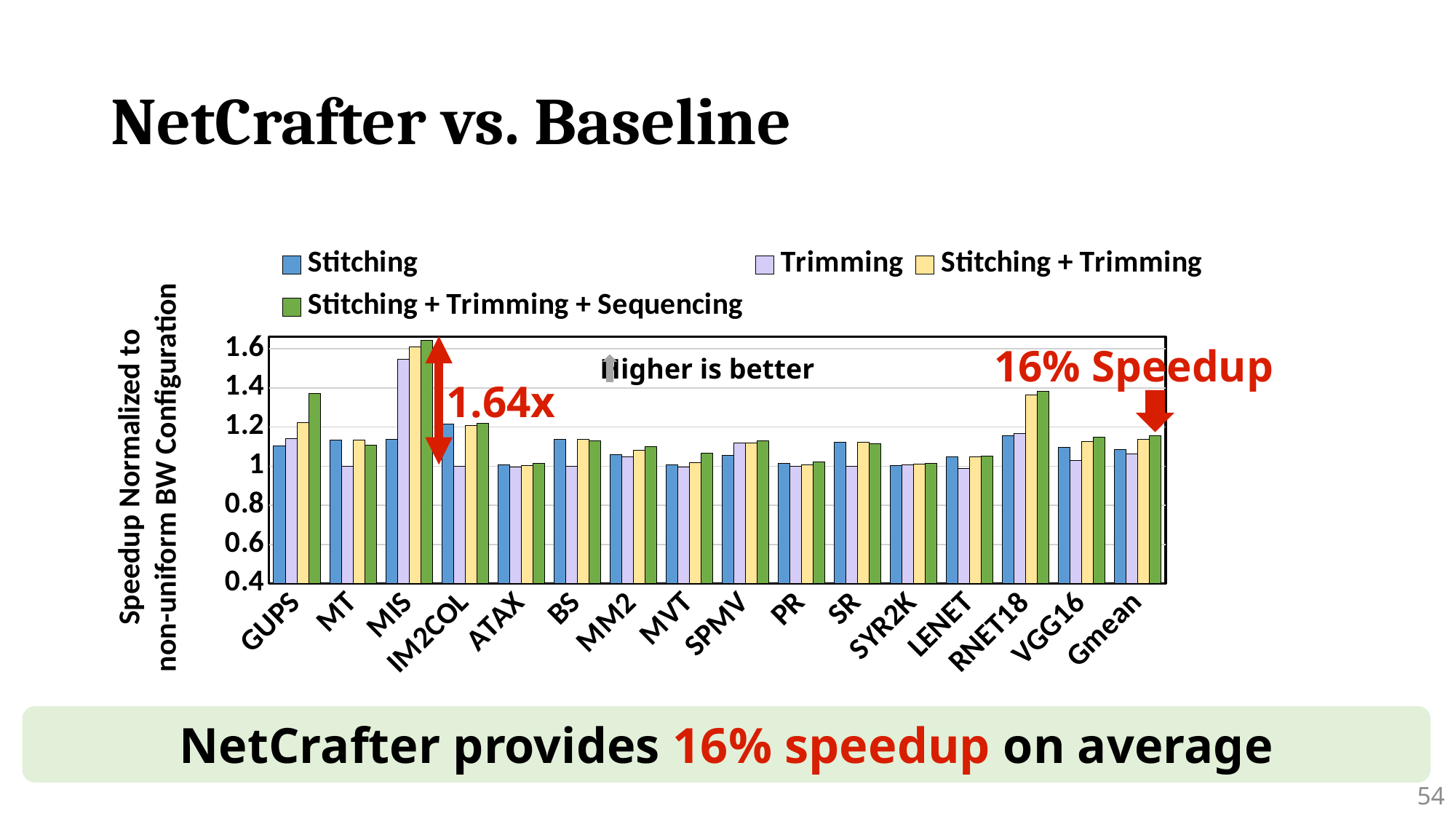
Is the Trimming value for MIS greater or less than 1.4? greater What kind of chart is shown on the slide? bar chart Is the Stitching + Trimming + Sequencing value for GUPS greater or less than 1.2? greater What average speedup is annotated on the chart at Gmean? 16% Speedup How many series does the legend list? 4 Which category has the highest Stitching + Trimming + Sequencing bar? MIS How many categories are shown along the x axis? 16 What speedup is annotated on the chart for MIS? 1.64x Is the Stitching + Trimming + Sequencing value for Gmean greater or less than 1.2? less For MIS, which is larger: the Stitching bar or the Trimming bar? Trimming What is the label on the y axis? Speedup Normalized to non-uniform BW Configuration For Stitching + Trimming + Sequencing, which is larger: RNET18 or VGG16? RNET18